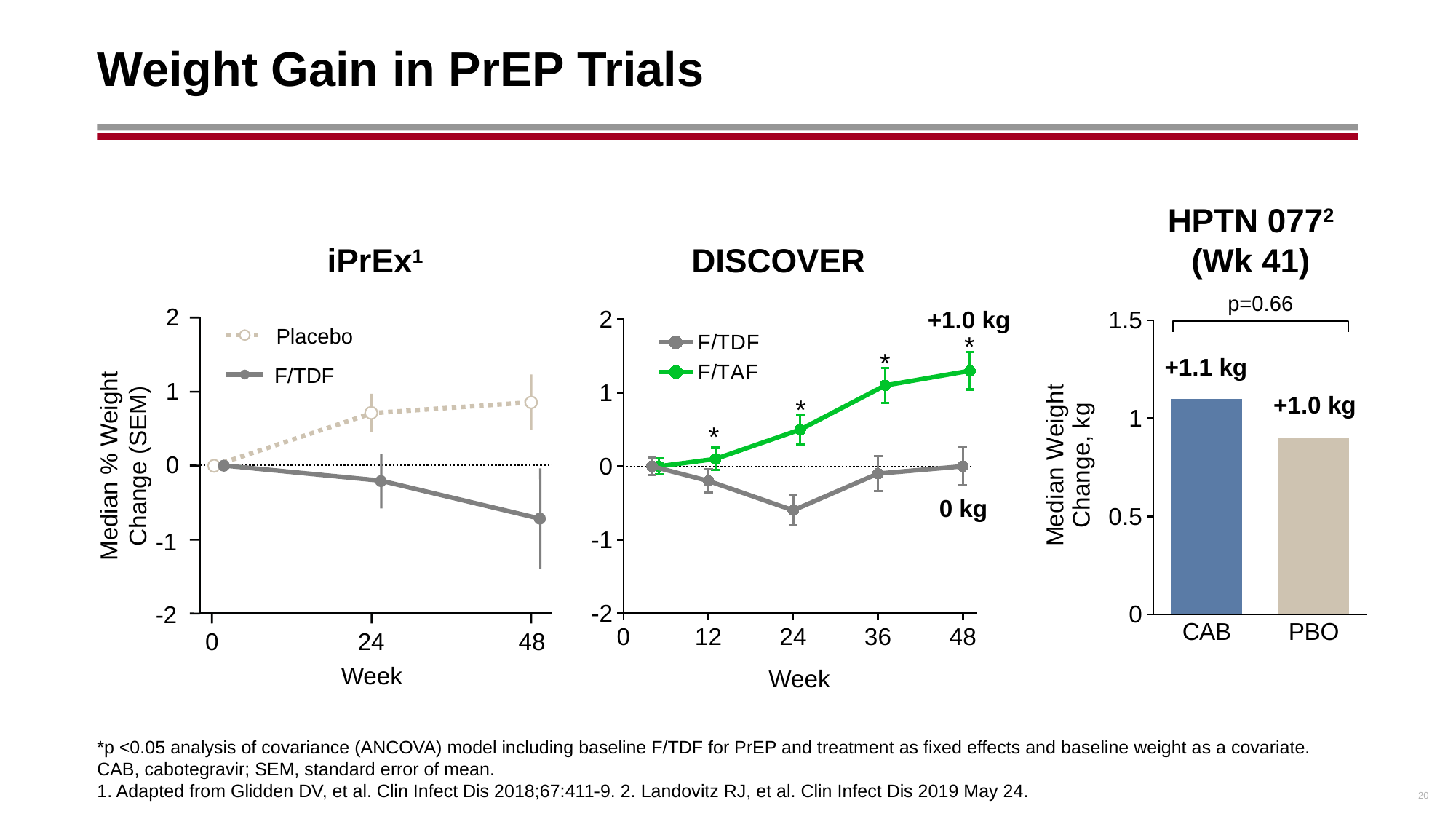
In the DISCOVER chart, is the F/TDF value at week 24 greater or less than 0? less In the HPTN 077 (Wk 41) chart, which group has the higher median weight change? CAB In the HPTN 077 (Wk 41) chart, what is the median weight change for CAB? +1.1 kg In the DISCOVER chart, what weight change is labelled for F/TAF at week 48? +1.0 kg In the HPTN 077 (Wk 41) chart, what p-value is shown above the bars? p=0.66 In the iPrEx chart, does the F/TDF line rise or fall from week 0 to week 48? fall What kind of chart is the HPTN 077 (Wk 41) chart on the right? bar chart In the HPTN 077 (Wk 41) chart, what is the difference between the CAB and PBO labelled values? 0.1 kg In the DISCOVER chart, what weight change is labelled for F/TDF at week 48? 0 kg What kind of chart is the iPrEx chart on the left? line chart In the HPTN 077 (Wk 41) chart, what is the median weight change for PBO? +1.0 kg In the iPrEx chart, how many series does the legend list? 2